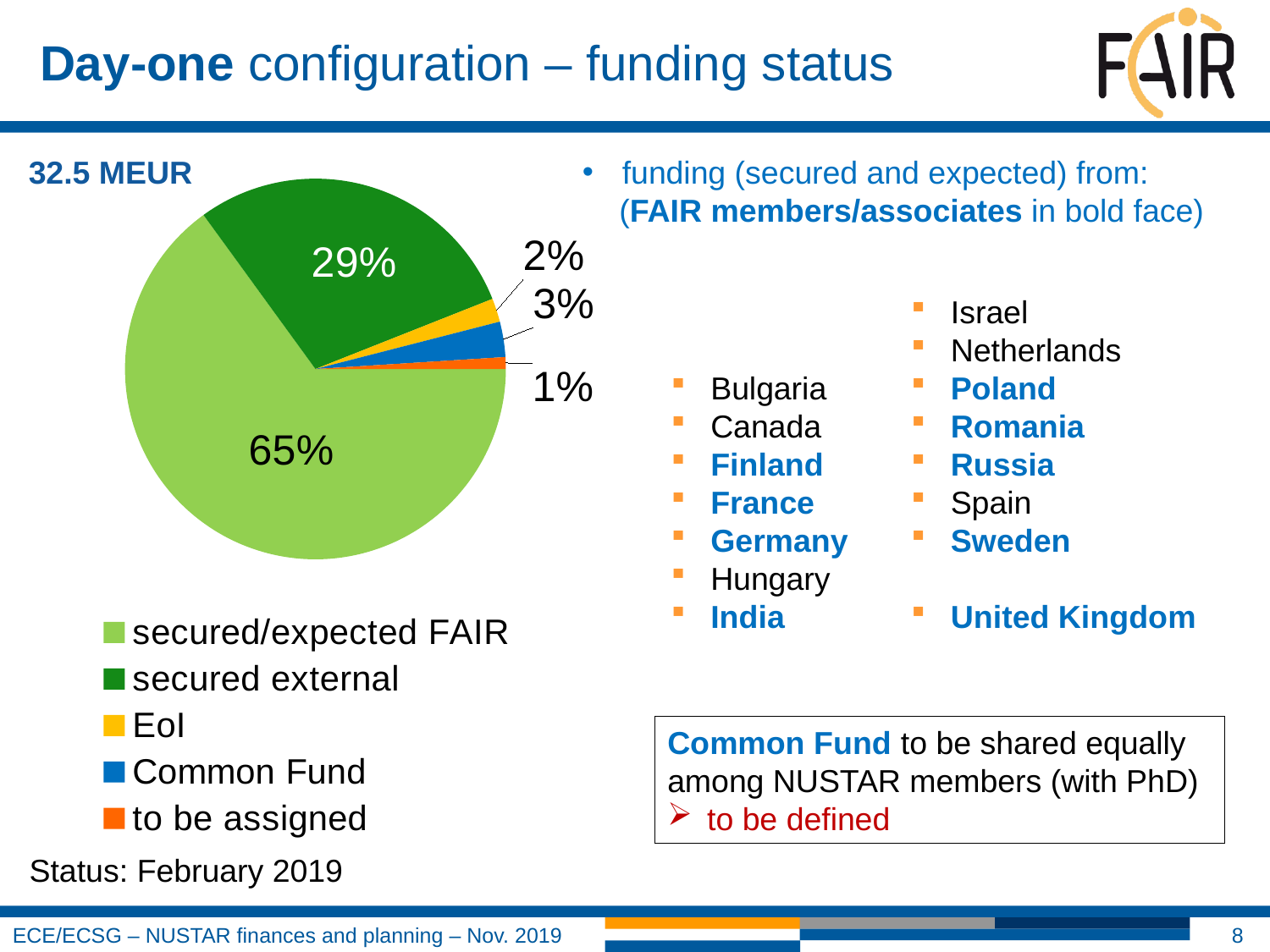
Which category has the largest slice of the pie? secured/expected FAIR What share of the pie is EoI? 2% What share of the pie is to be assigned? 1% What share of the pie is secured external? 29% How many categories does the pie chart legend list? 5 Which is larger, the Common Fund slice or the EoI slice? Common Fund What share of the pie is Common Fund? 3% What total amount is stated above the pie chart? 32.5 MEUR What is the difference in percentage points between secured/expected FAIR and secured external? 36 What type of chart is shown on the slide? pie chart Which category has the smallest slice of the pie? to be assigned What share of the pie is secured/expected FAIR? 65%